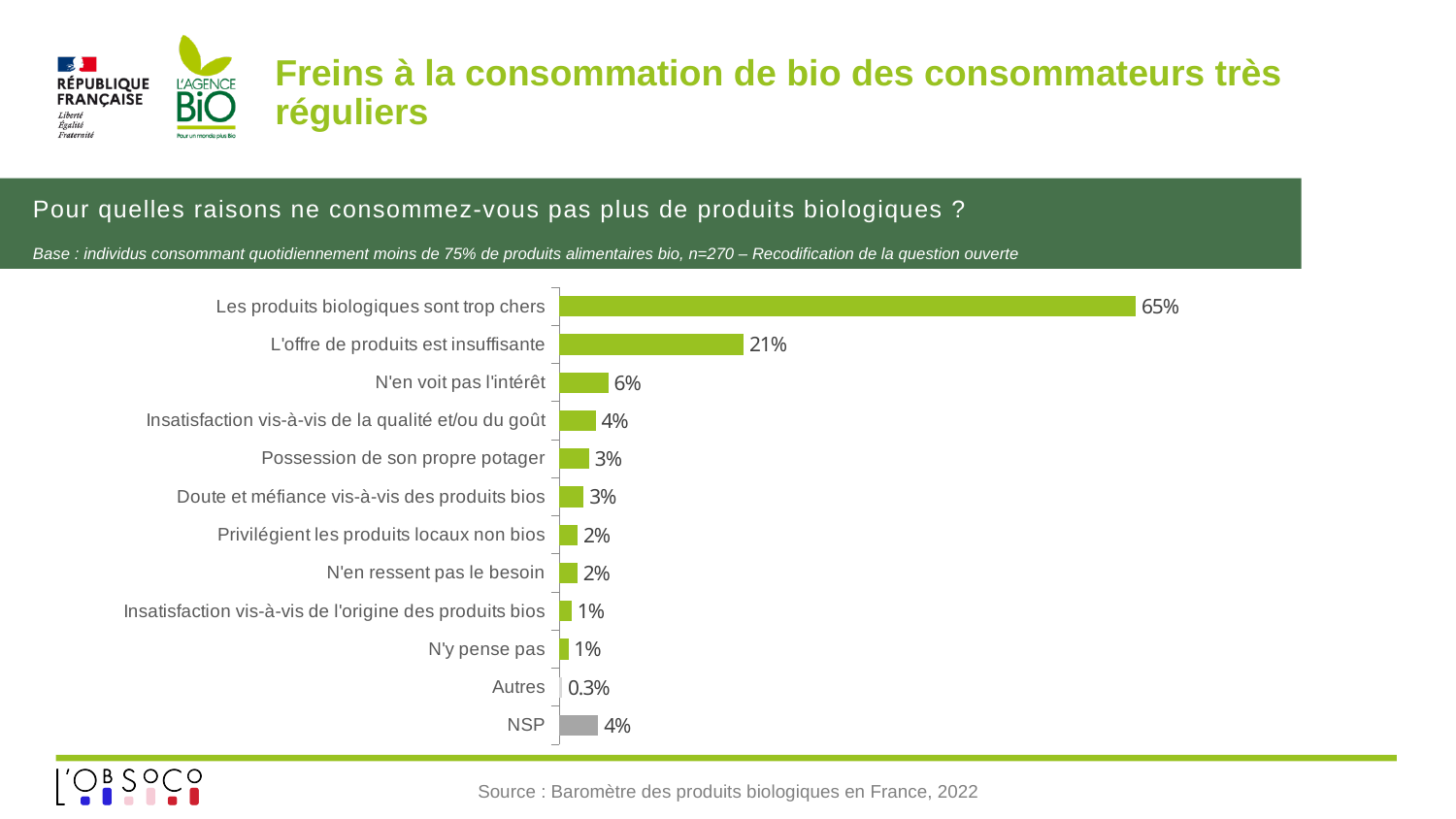
What type of chart is shown on the slide? Bar chart What is the value for "Autres"? 0.3% What is the difference in percentage points between "Les produits biologiques sont trop chers" and "L'offre de produits est insuffisante"? 44 Which bar is coloured grey instead of green? NSP What is the value for "NSP"? 4% What is the value for "L'offre de produits est insuffisante"? 21% Which category has the lowest percentage? Autres What is the value for "Possession de son propre potager"? 3% How many categories are shown in the chart? 12 What percentage of respondents say organic products are too expensive ("Les produits biologiques sont trop chers")? 65% Which reason has the highest percentage? Les produits biologiques sont trop chers Which is larger: the value for "N'en voit pas l'intérêt" or the value for "Insatisfaction vis-à-vis de la qualité et/ou du goût"? N'en voit pas l'intérêt